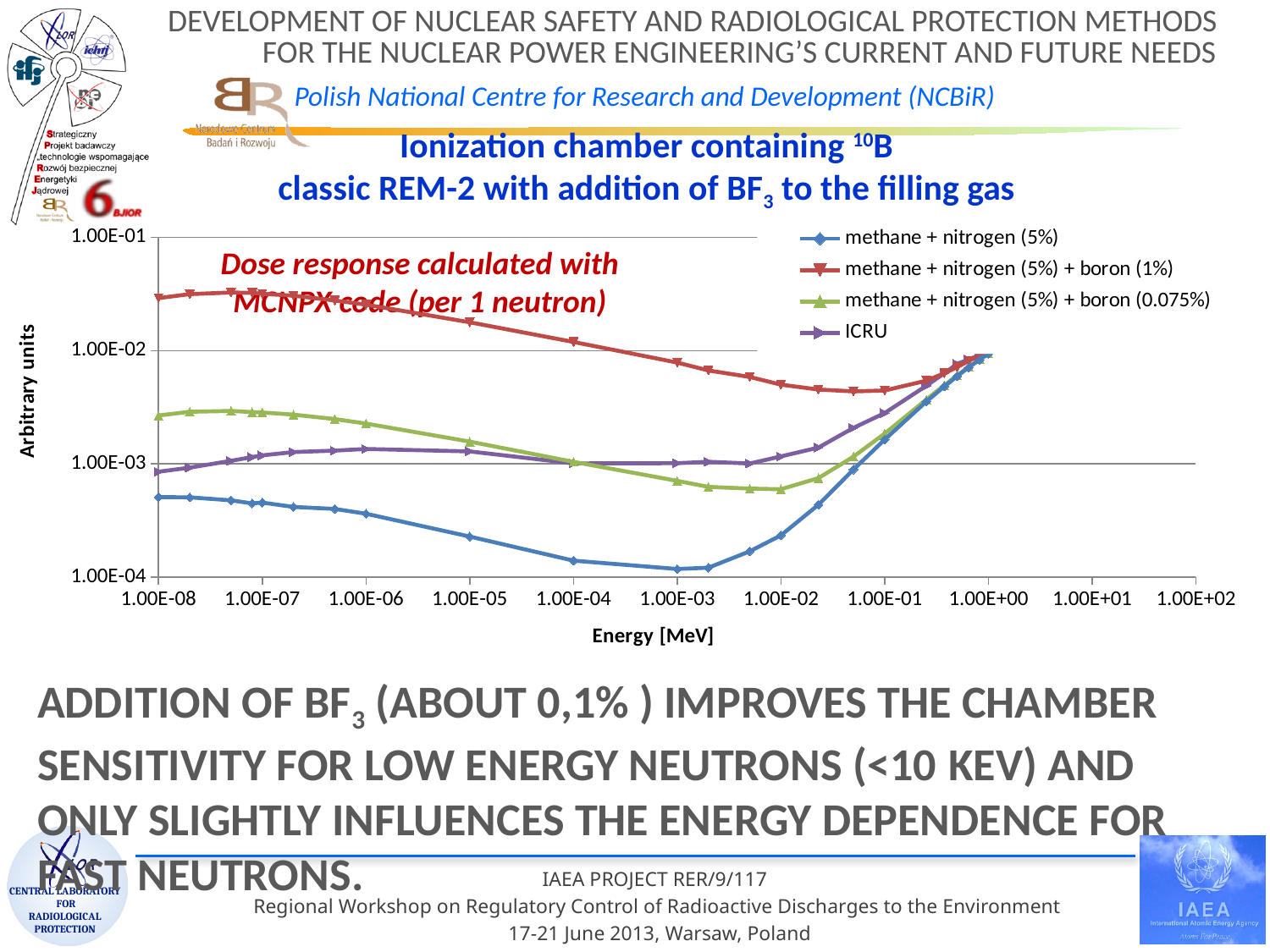
Is the value for the methane + nitrogen (5%) + boron (1%) series at 1.00E-08 MeV greater or less than 1.00E-02? greater Is the value for the methane + nitrogen (5%) series at 1.00E-08 MeV greater or less than 1.00E-03? less What is the title of the y axis of the chart? Arbitrary units Is the value for the methane + nitrogen (5%) + boron (1%) series at 1.00E-02 MeV greater or less than 1.00E-02? less How many series does the chart legend list? 4 Which series has the lowest values at 1.00E-08 MeV? methane + nitrogen (5%) Does the methane + nitrogen (5%) series rise or fall between 1.00E-08 MeV and 1.00E-03 MeV? fall What is the title of the x axis of the chart? Energy [MeV] What kind of chart is shown on the slide? line chart Which series has the highest values at 1.00E-08 MeV? methane + nitrogen (5%) + boron (1%) At 1.00E-04 MeV, which is larger: the ICRU series or the methane + nitrogen (5%) series? ICRU